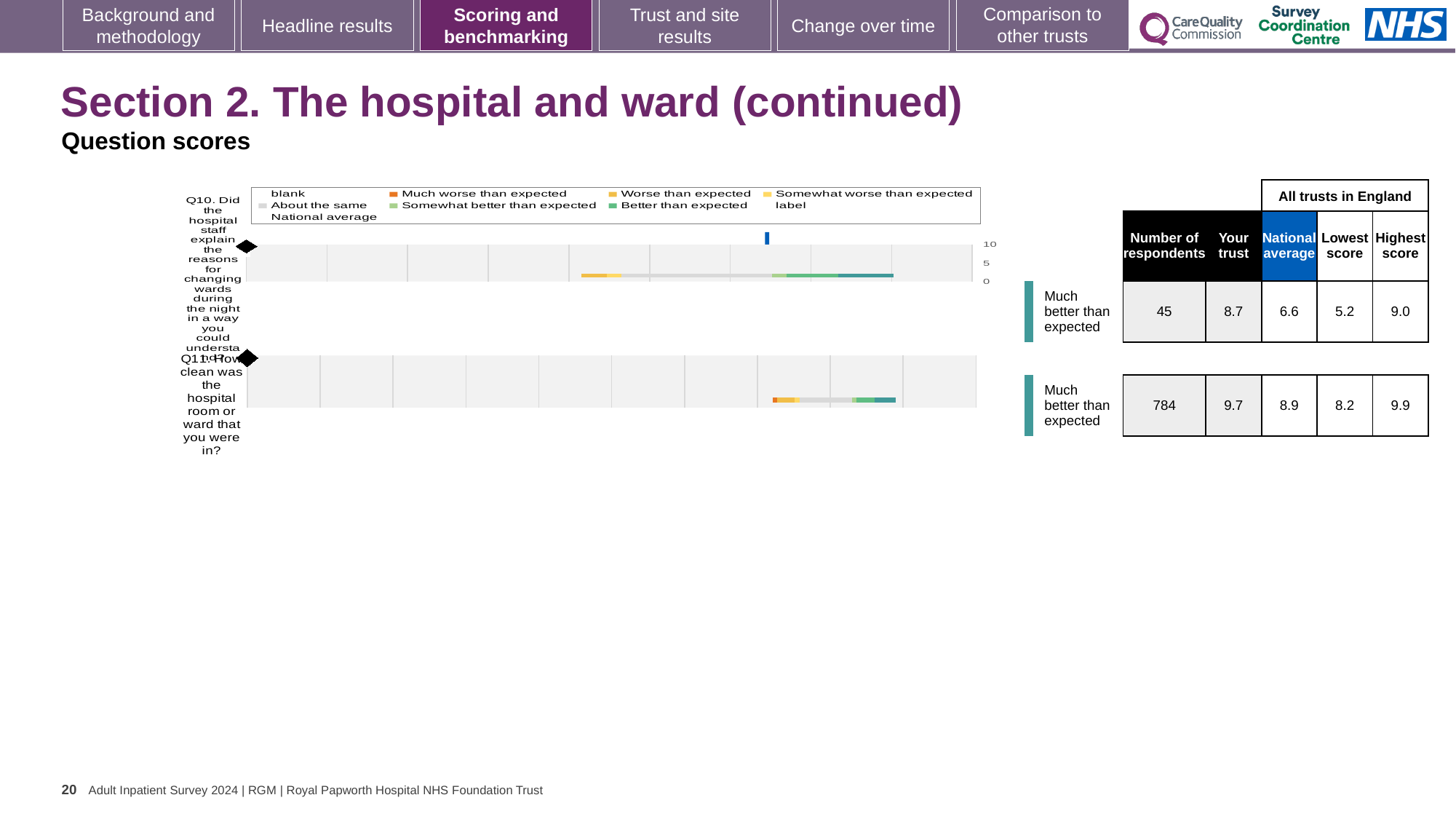
What is the national average score for Q11 (how clean was the hospital room or ward)? 8.9 What is the lowest score among all trusts in England for Q10? 5.2 What kind of chart is used to show the Q10 and Q11 question scores? bar chart Which benchmark category is shown for Q11? Much better than expected How many entries does the chart legend list? 9 What is the highest tick value shown on the x axis of the Q10 chart? 10 What is the highest score among all trusts in England for Q11? 9.9 What is the 'Your trust' score for Q10 (explaining reasons for changing wards during the night)? 8.7 For Q10, how much higher is the 'Your trust' score than the national average? 2.1 How many survey questions are plotted on the slide? 2 For Q11, which is larger: the 'Your trust' score or the national average? Your trust How many respondents answered Q10? 45